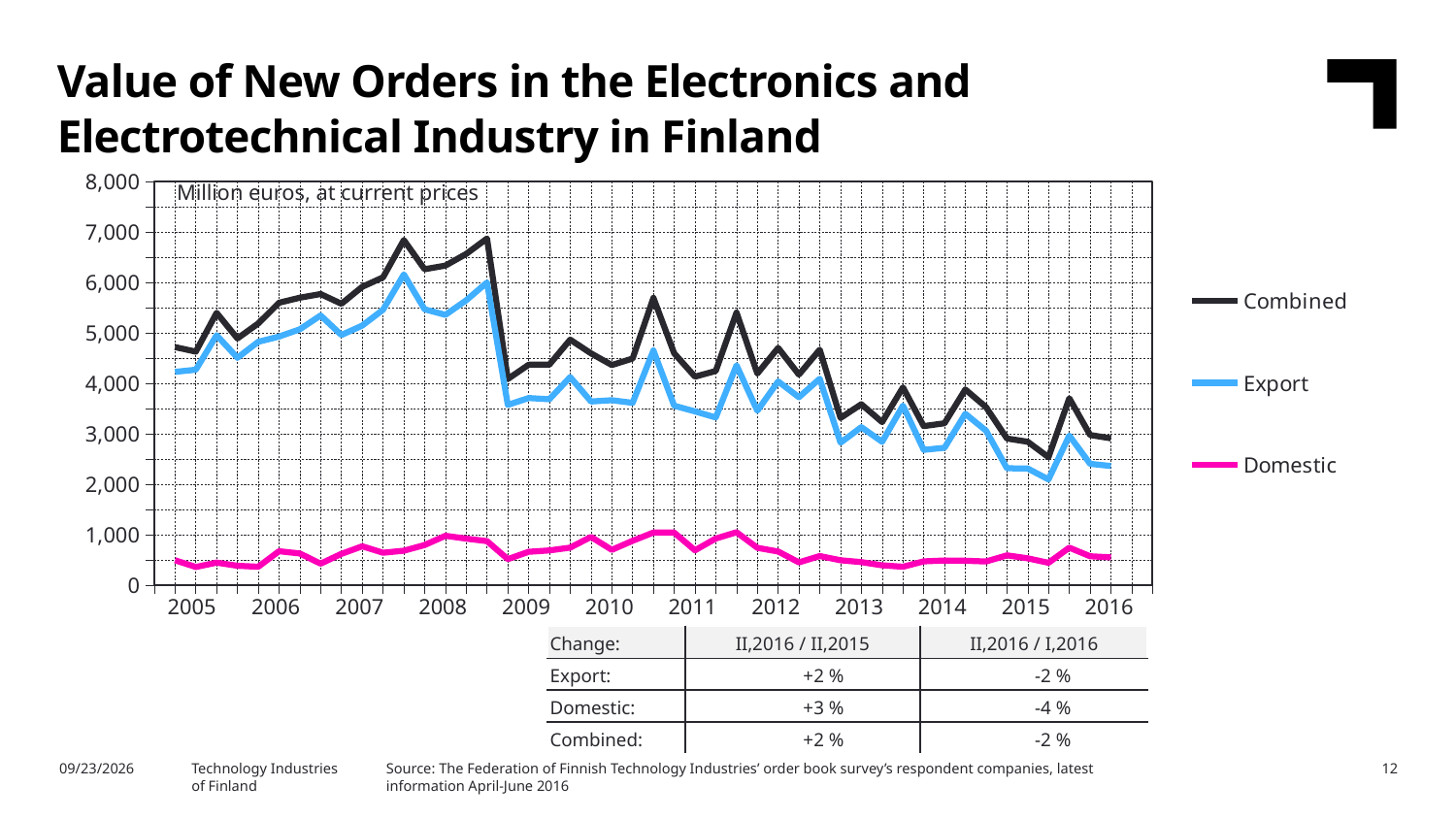
How many years are labelled on the x axis? 12 What type of chart is shown on the slide? line chart Is the value of the Export series in 2016 greater or less than 3,000? less Which series has the lowest values throughout the chart? Domestic Does the Combined series rise or fall overall from 2008 to 2016? fall Is the value of the Combined series in 2016 greater or less than 4,000? less Is the peak value of the Combined series in 2008 greater or less than 6,000? greater Which series are listed in the chart legend? Combined, Export, Domestic What unit is stated in the label inside the chart area? Million euros, at current prices How many series does the legend list? 3 Which series has the highest values throughout the chart? Combined